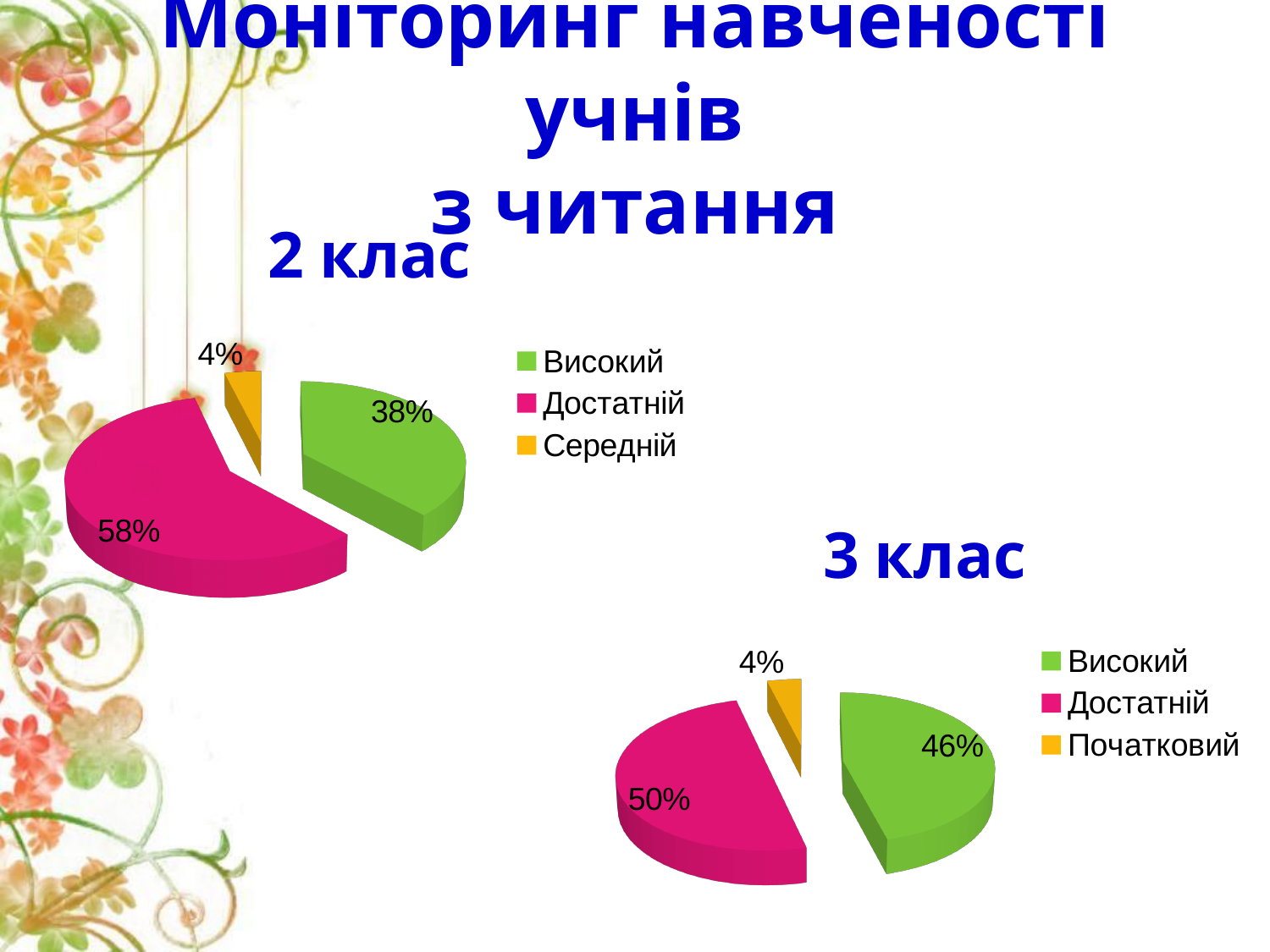
In the "3 клас" chart, what share is labelled for Початковий? 4% In the "2 клас" chart, what is the difference between the Достатній and Високий shares? 20% In the "3 клас" chart, what is the difference between the Достатній and Високий shares? 4% How many slices does the "3 клас" chart have? 3 In the "2 клас" chart, what share is labelled for Достатній? 58% What type of chart is used for "2 клас"? Pie chart Which is larger in the "2 клас" chart: the Високий slice or the Середній slice? Високий In the "2 клас" chart, what share is labelled for Високий? 38% Which legend entry in the "3 клас" chart is shown in orange? Початковий In the "3 клас" chart, which category has the smallest slice? Початковий In the "2 клас" chart, which category has the largest slice? Достатній In the "3 клас" chart, what share is labelled for Високий? 46%